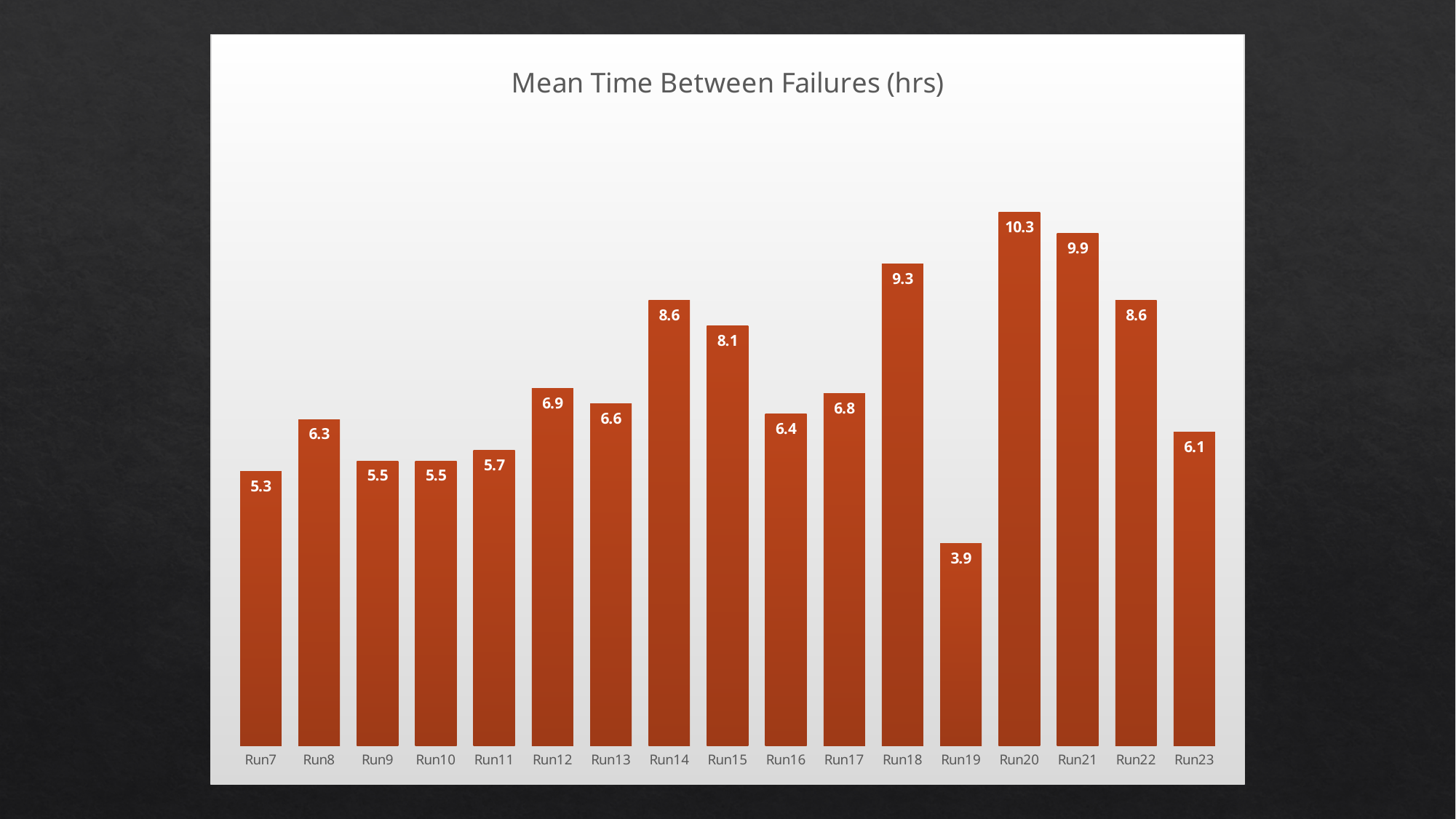
Which run has the highest Mean Time Between Failures? Run20 What is the difference between the values for Run18 and Run17? 2.5 What is the title of the chart? Mean Time Between Failures (hrs) What kind of chart is shown on the slide? Bar chart What is the value shown for Run19? 3.9 What is the Mean Time Between Failures value for Run14? 8.6 How many runs are shown on the chart? 17 Do the values rise or fall from Run7 to Run12? Rise Which has a larger value, Run21 or Run22? Run21 Which run has the lowest Mean Time Between Failures? Run19 Which has a larger value, Run8 or Run11? Run8 What is the difference between the values for Run20 and Run19? 6.4